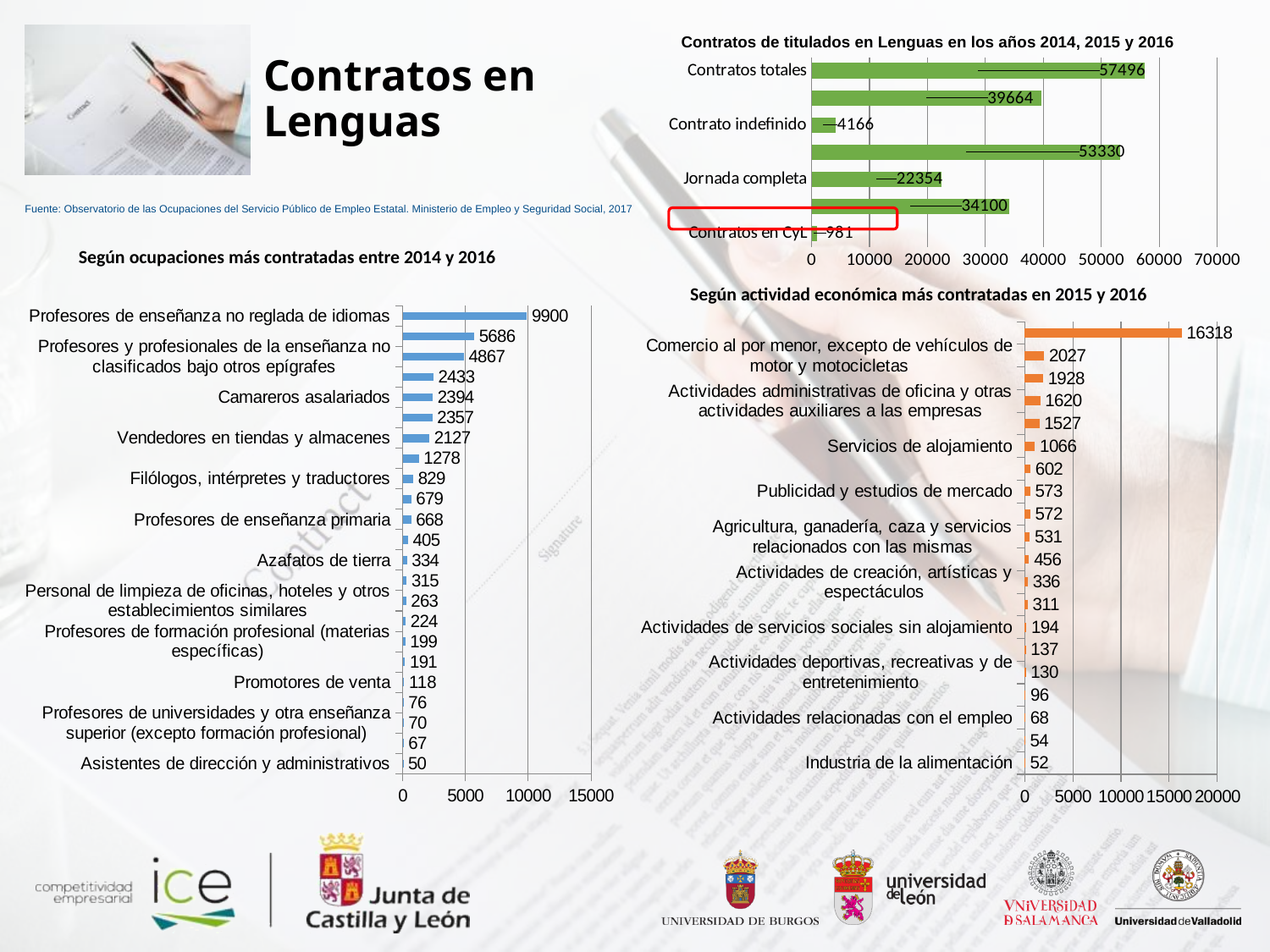
In the chart 'Según ocupaciones más contratadas entre 2014 y 2016', which is larger: Filólogos, intérpretes y traductores or Promotores de venta? Filólogos, intérpretes y traductores In the chart 'Según actividad económica más contratadas en 2015 y 2016', what is the value for Servicios de alojamiento? 1066 In the chart 'Contratos de titulados en Lenguas en los años 2014, 2015 y 2016', what is the value for Jornada completa? 22354 What type of chart is 'Según actividad económica más contratadas en 2015 y 2016'? Bar chart In the chart 'Contratos de titulados en Lenguas en los años 2014, 2015 y 2016', what is the value for Contratos en CyL? 981 In the chart 'Contratos de titulados en Lenguas en los años 2014, 2015 y 2016', what is the value for Contratos totales? 57496 In the chart 'Según actividad económica más contratadas en 2015 y 2016', what is the value of the largest bar? 16318 In the chart 'Según actividad económica más contratadas en 2015 y 2016', what is the value for Industria de la alimentación? 52 In the chart 'Según ocupaciones más contratadas entre 2014 y 2016', what is the value for Camareros asalariados? 2394 In the chart 'Según ocupaciones más contratadas entre 2014 y 2016', what is the value for Profesores de enseñanza no reglada de idiomas? 9900 In the chart 'Contratos de titulados en Lenguas en los años 2014, 2015 y 2016', what is the difference between Contratos totales and Contrato indefinido? 53330 In the chart 'Según ocupaciones más contratadas entre 2014 y 2016', which occupation has the highest value? Profesores de enseñanza no reglada de idiomas